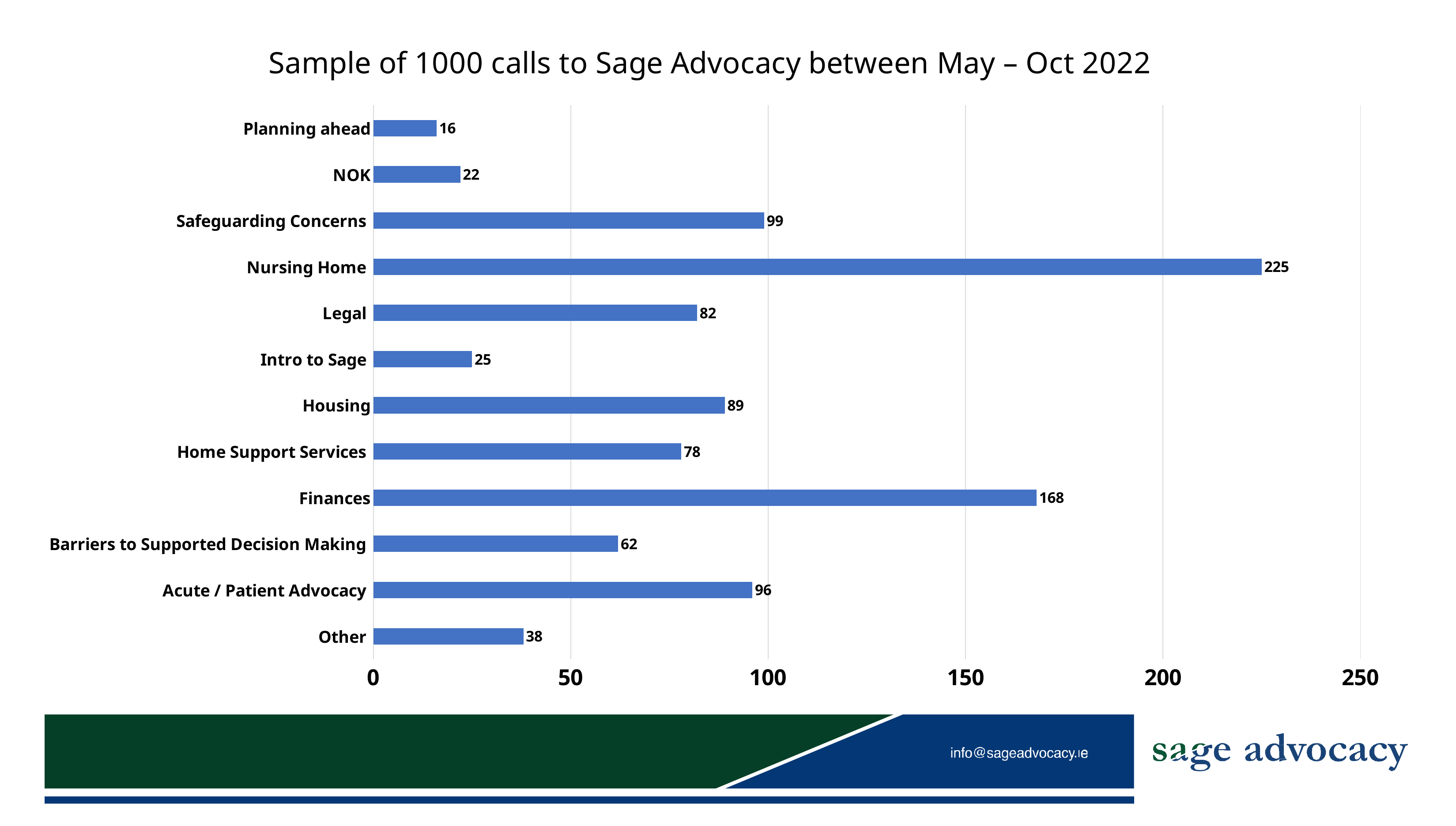
What is the value for Nursing Home? 225 What is the value for Barriers to Supported Decision Making? 62 Is the value for Housing greater or less than 100? less How many categories are shown in the chart? 12 What is the value for Finances? 168 Which category has the lowest value? Planning ahead Which is larger, the value for Safeguarding Concerns or the value for Acute / Patient Advocacy? Safeguarding Concerns What is the difference between the values for Nursing Home and Finances? 57 What is the difference between the values for Legal and Home Support Services? 4 What is the title of the chart? Sample of 1000 calls to Sage Advocacy between May – Oct 2022 Which category has the highest value? Nursing Home What kind of chart is shown on the slide? bar chart